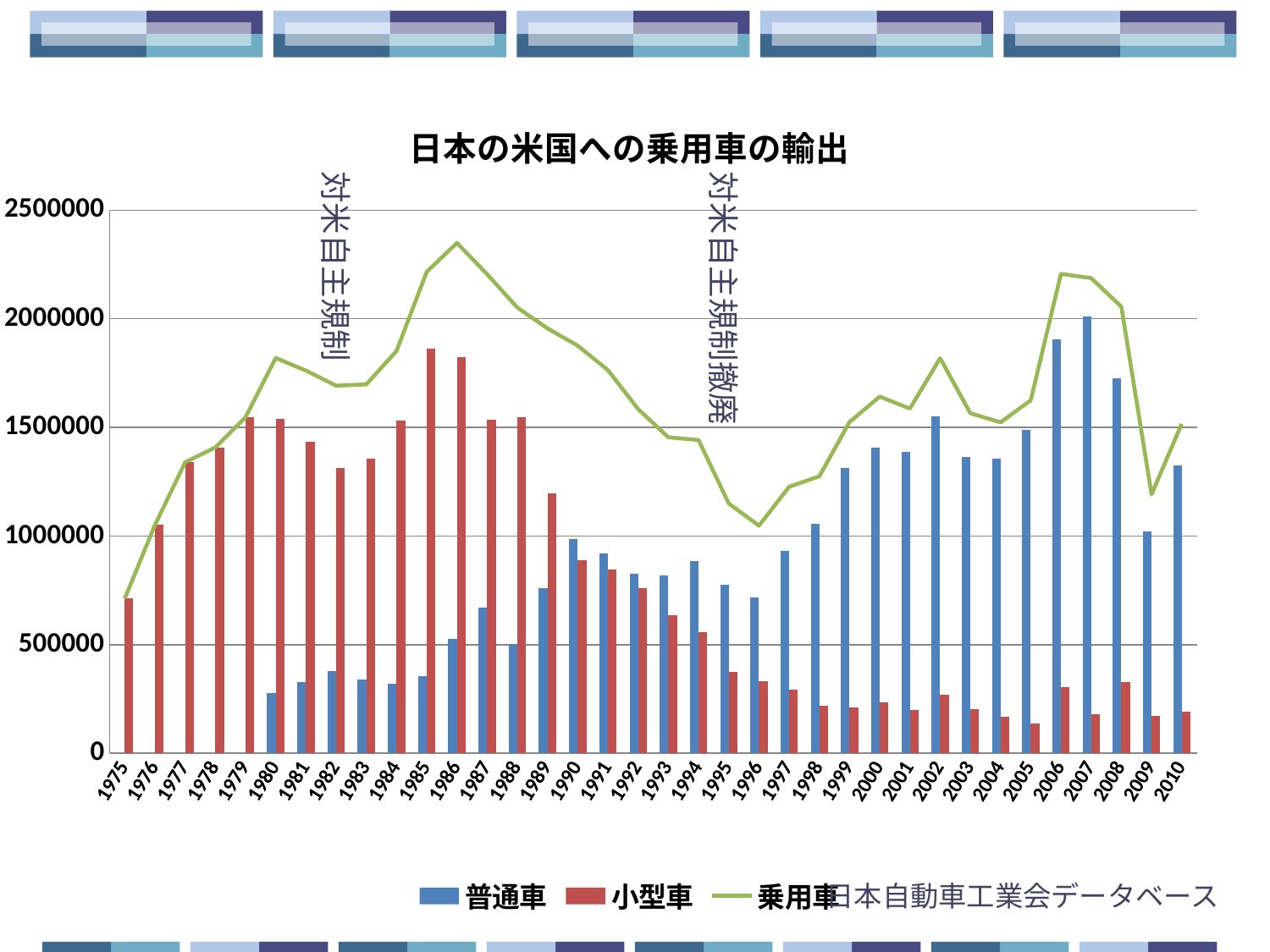
How many years are shown on the x axis? 36 Is the value for 小型車 in 1985 greater or less than 1500000? greater In which year is the 普通車 bar highest? 2007 In 2007, which is larger, 普通車 or 小型車? 普通車 Is the value for 普通車 in 1980 greater or less than 500000? less What is the title of the chart? 日本の米国への乗用車の輸出 In which year does the 乗用車 line reach its highest point? 1986 In 1985, which is larger, 普通車 or 小型車? 小型車 Is the value of the 乗用車 line in 1996 greater or less than 1500000? less How many series does the legend list? 3 Do the 小型車 values rise or fall from 1989 to 2005? fall What kind of chart is shown on the slide? A combined bar and line chart